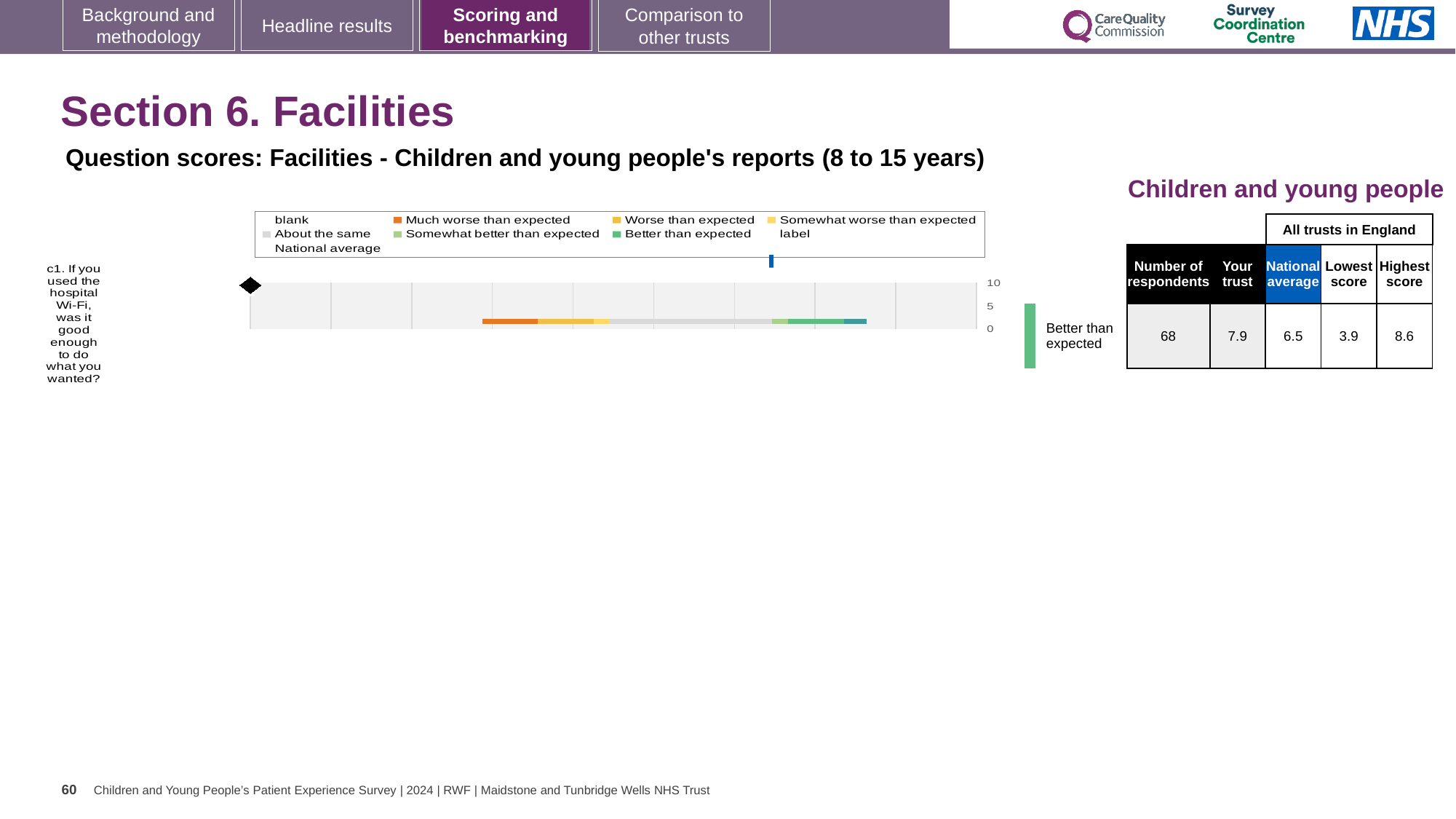
What is the number of respondents for question c1 about hospital Wi-Fi? 68 What is the highest score among all trusts in England for question c1? 8.6 What is the lowest score among all trusts in England for question c1? 3.9 What is the 'Your trust' score for question c1? 7.9 What is the difference between the highest and lowest scores for question c1? 4.7 By how much does the trust's score exceed the national average for question c1? 1.4 Which is larger for question c1: the trust's score or the national average? The trust's score (7.9) Which benchmarking category is question c1 rated as? Better than expected How many survey questions are plotted on the chart? 1 What is the national average score for question c1? 6.5 What is the maximum value shown on the score axis of the chart? 10 What kind of chart is used to show the question score for c1? Bar chart